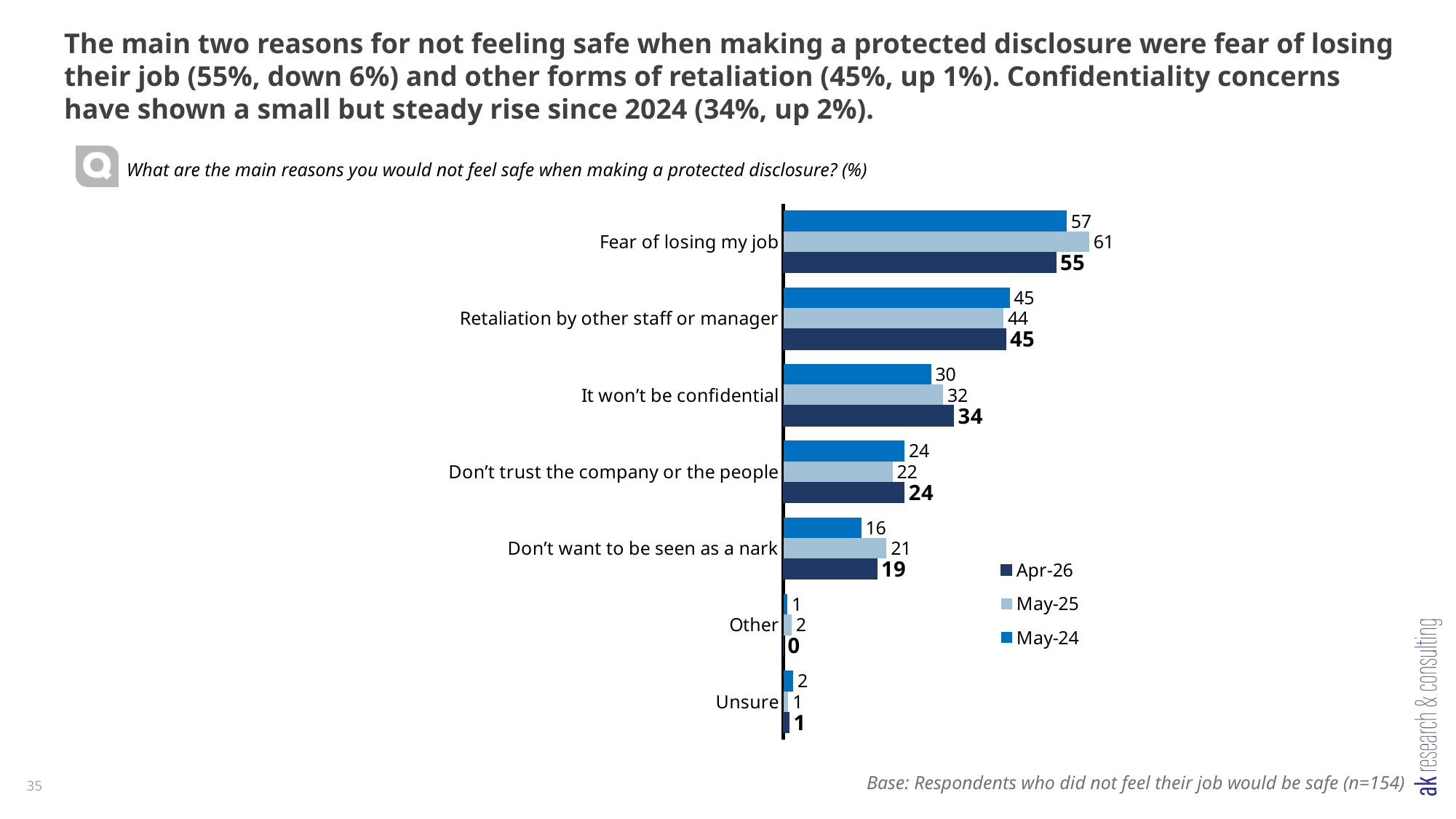
What kind of chart is shown on the slide? Bar chart Which is larger for "Don't want to be seen as a nark": the May-24 value or the May-25 value? May-25 What is the Apr-26 value for "Don't want to be seen as a nark"? 19 How many categories are shown on the chart? 7 What is the Apr-26 value for "Fear of losing my job"? 55 How many series does the legend list? 3 What is the May-25 value for "Retaliation by other staff or manager"? 44 What is the May-24 value for "It won't be confidential"? 30 Which category has the highest Apr-26 value? Fear of losing my job What is the difference between the May-25 and Apr-26 values for "Fear of losing my job"? 6 Which series is shown in the darkest blue colour? Apr-26 Which category has the lowest Apr-26 value? Other